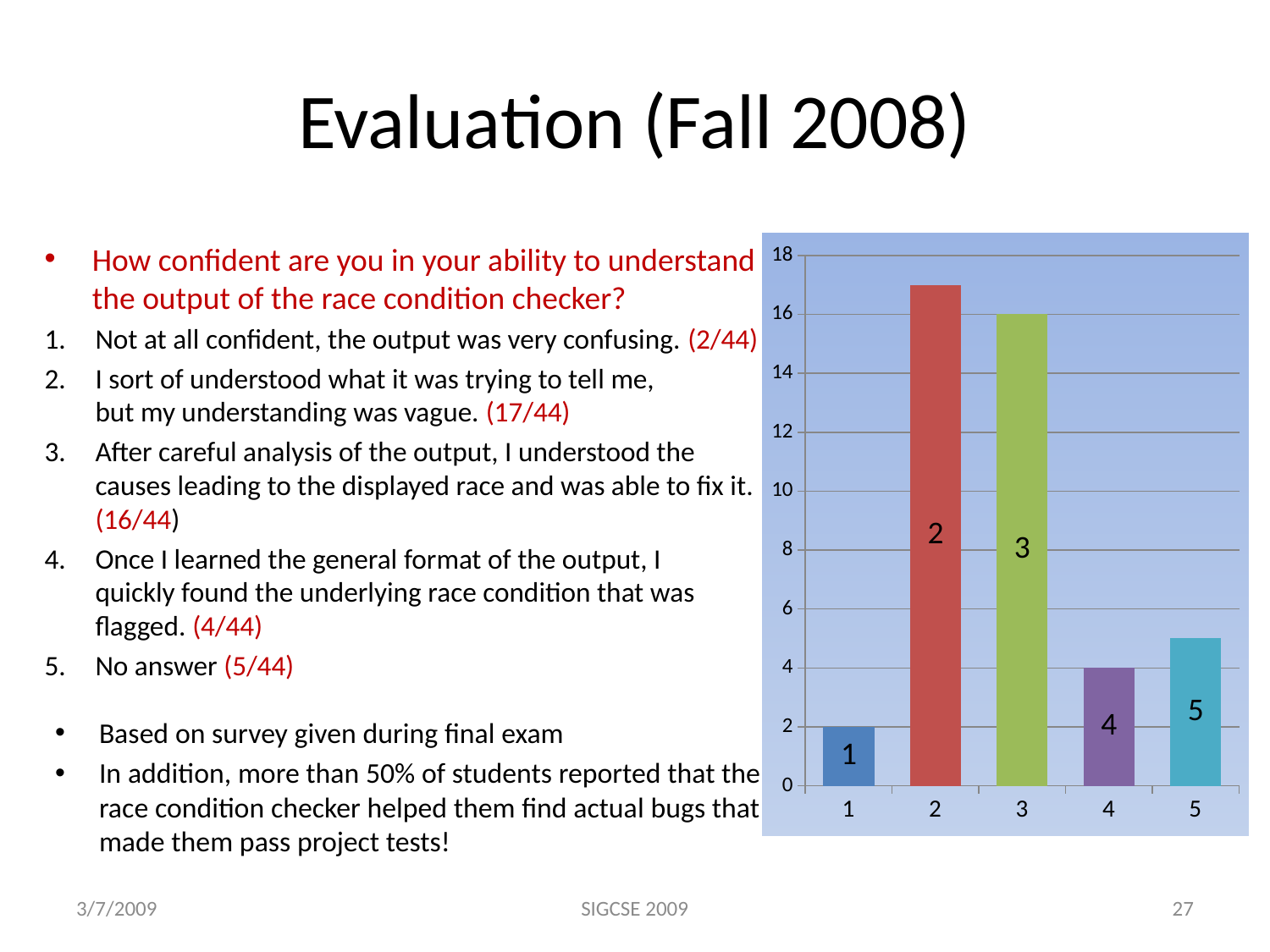
Is the value for category 2 greater or less than 16? greater Which category has the shortest bar? 1 What colour is the bar for category 2? red What is the difference between the values for category 3 and category 1? 14 How many bars (categories) does the chart show? 5 Which category has the tallest bar? 2 Is the value for category 5 greater or less than 6? less Which bar is taller, category 4 or category 5? 5 What is the value of the bar for category 4? 4 What is the value of the bar for category 3? 16 What kind of chart is shown on the slide? bar chart What is the value of the bar for category 1? 2